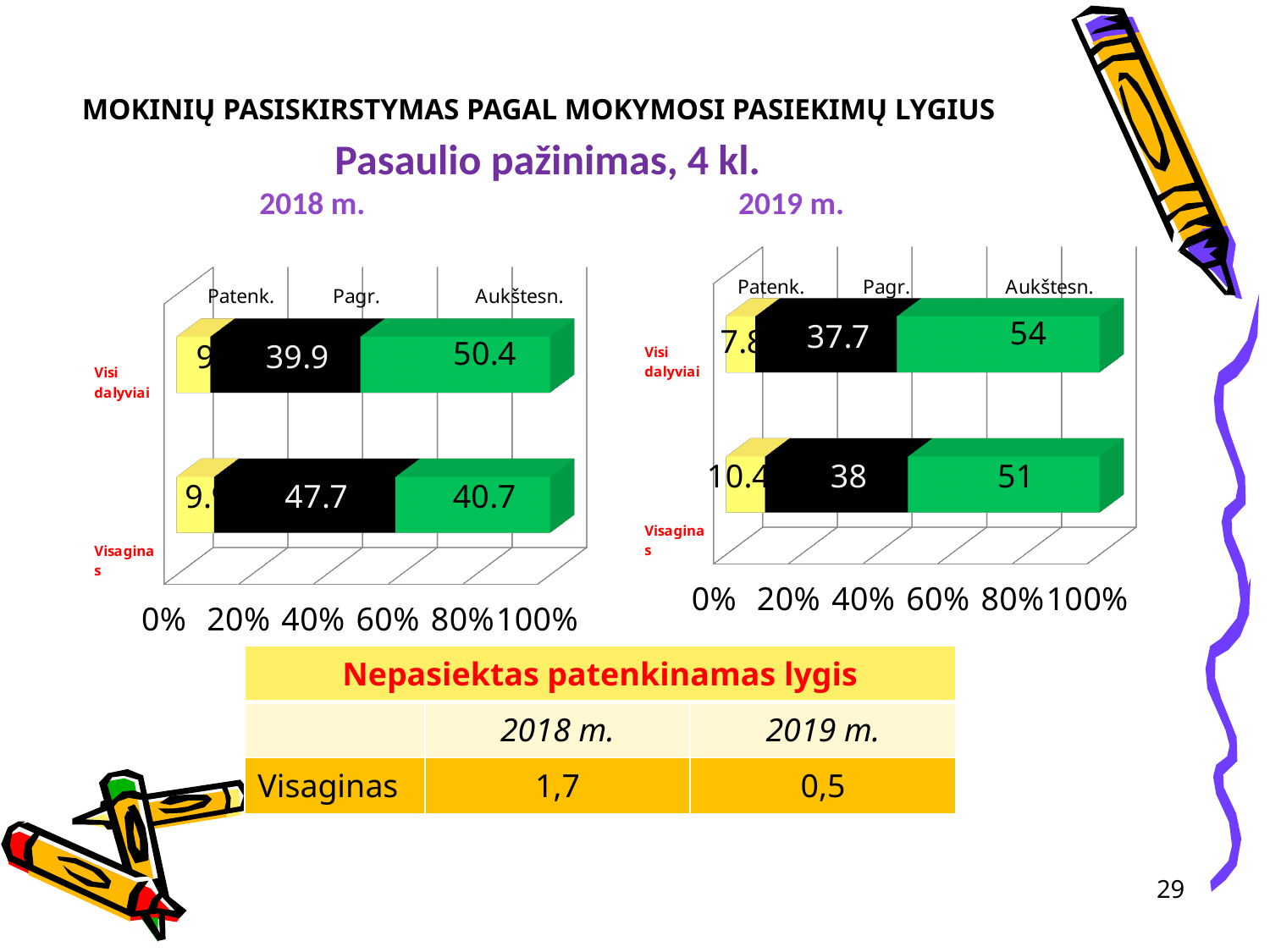
In the 2019 m. chart, what is the difference between the Patenk. values for Visaginas and Visi dalyviai? 2.6 In the 2019 m. chart, what is the Pagr. value for Visi dalyviai? 37.7 In the 2018 m. chart, what is the Pagr. value for Visi dalyviai? 39.9 In the 2019 m. chart, what is the Patenk. value for Visaginas? 10.4 What kind of chart is the 2018 m. chart? Stacked bar chart In the 2019 m. chart, what is the Aukštesn. value for Visi dalyviai? 54 In the 2018 m. chart, what is the Aukštesn. value for Visaginas? 40.7 In the 2019 m. chart, which category has the larger Aukštesn. value, Visi dalyviai or Visaginas? Visi dalyviai How many categories are shown in the 2018 m. chart? 2 In the 2018 m. chart, what is the Pagr. value for Visaginas? 47.7 In the 2018 m. chart, what is the difference between the Aukštesn. values for Visi dalyviai and Visaginas? 9.7